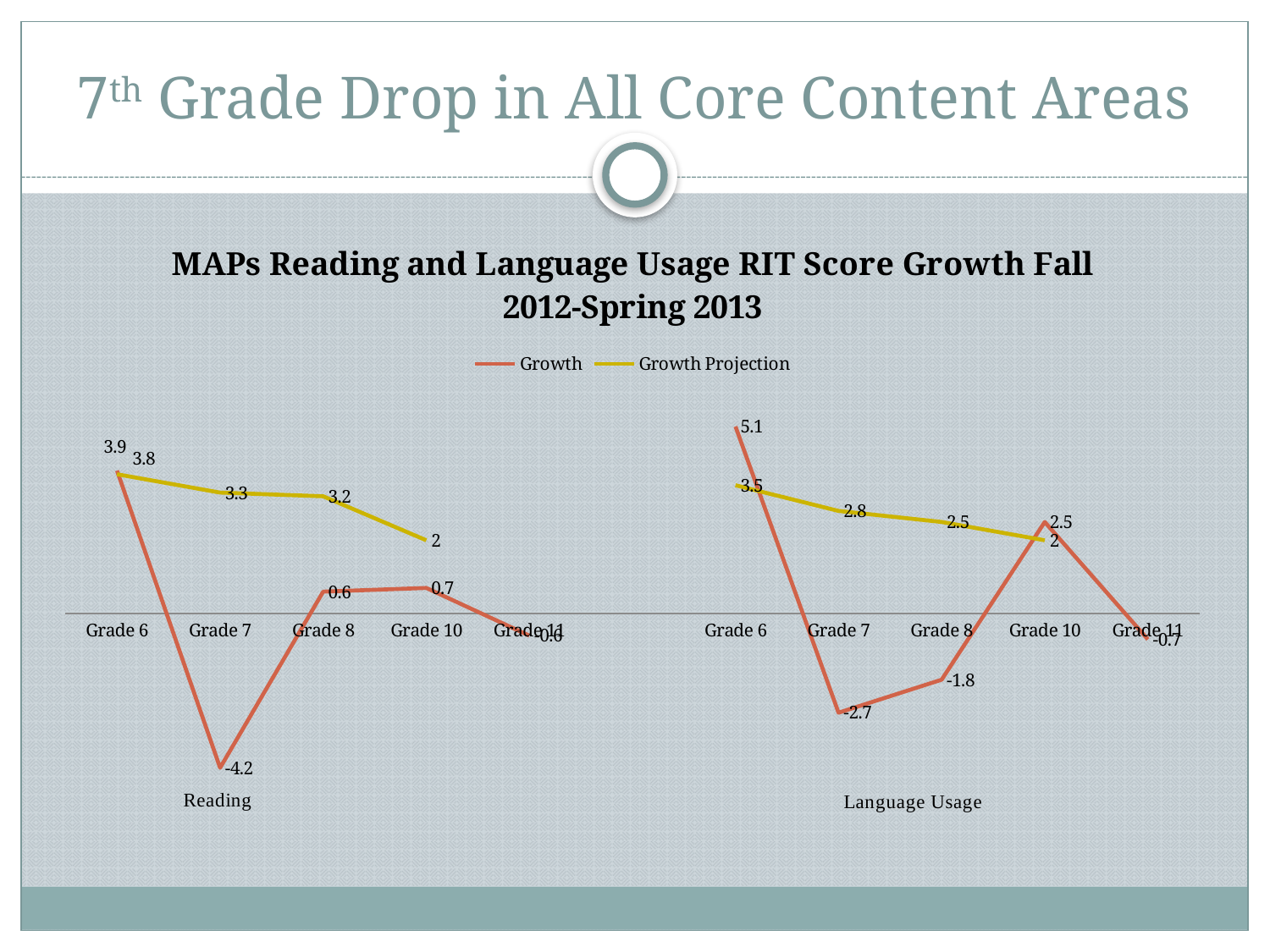
What is the Growth value for Grade 6 in Language Usage? 5.1 Which is larger for Grade 6 in Language Usage, the Growth or the Growth Projection? Growth Does the Growth Projection line rise or fall from Grade 6 to Grade 10 in Reading? fall What is the Growth value for Grade 8 in Language Usage? -1.8 What is the difference between the Growth Projection and the Growth for Grade 7 in Reading? 7.5 What is the Growth Projection value for Grade 8 in Reading? 3.2 How many series does the legend list? 2 Which grade has the highest Growth value in Language Usage? Grade 6 What type of chart is shown on the slide? line chart What is the Growth value for Grade 7 in Reading? -4.2 What is the title of the chart? MAPs Reading and Language Usage RIT Score Growth Fall 2012-Spring 2013 Which grade has the lowest Growth value in Reading? Grade 7